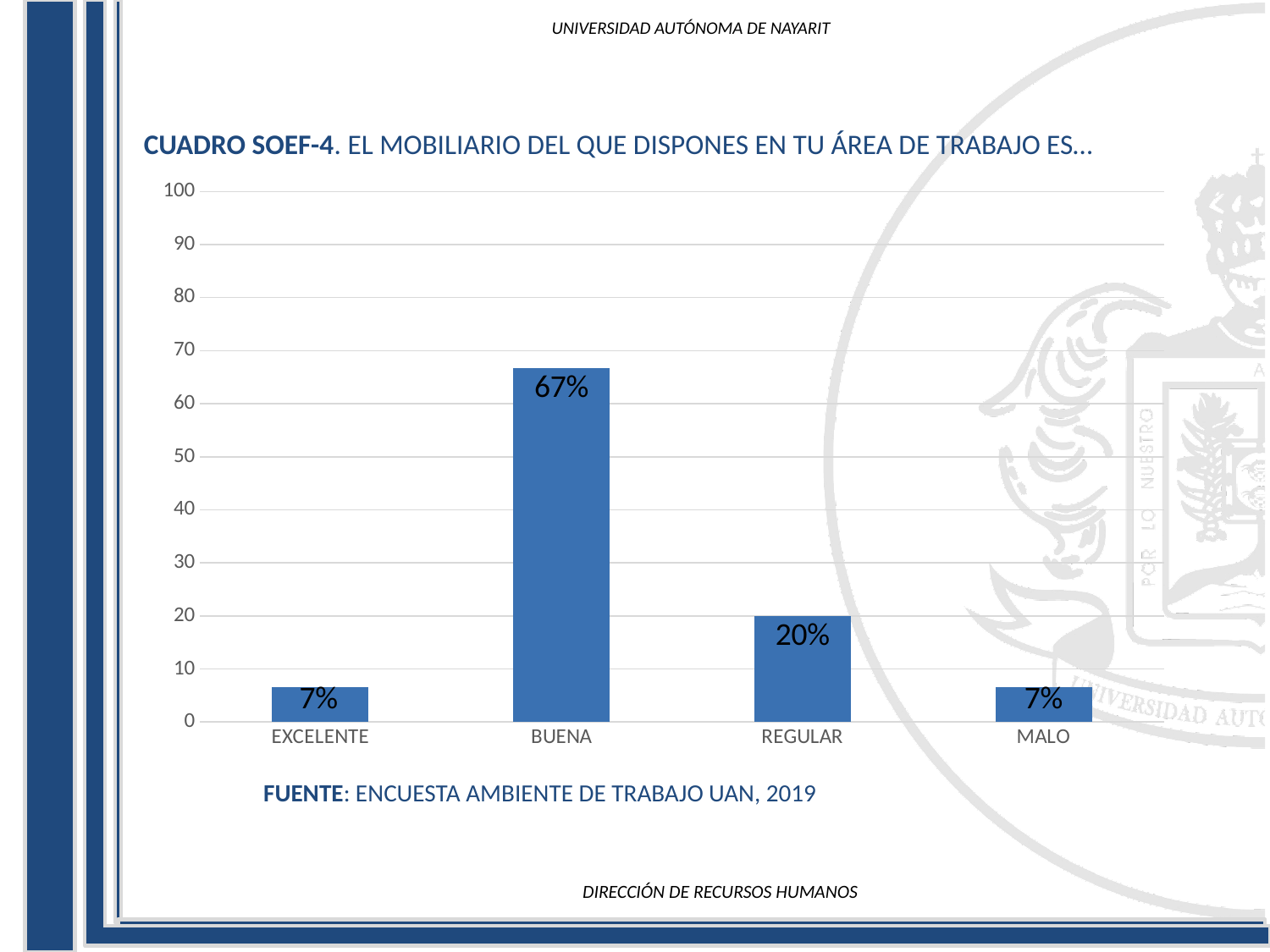
What kind of chart is shown on the slide? bar chart Is the value for MALO greater or less than 10? less What is the value for BUENA? 67% What source is cited below the chart? ENCUESTA AMBIENTE DE TRABAJO UAN, 2019 Is the value for BUENA greater or less than 60? greater Which category has the highest value? BUENA How many categories are shown on the x axis? 4 What is the difference between the values for BUENA and REGULAR? 47% What is the value for EXCELENTE? 7% Which is larger, the value for REGULAR or the value for EXCELENTE? REGULAR What is the value for REGULAR? 20% What is the value for MALO? 7%